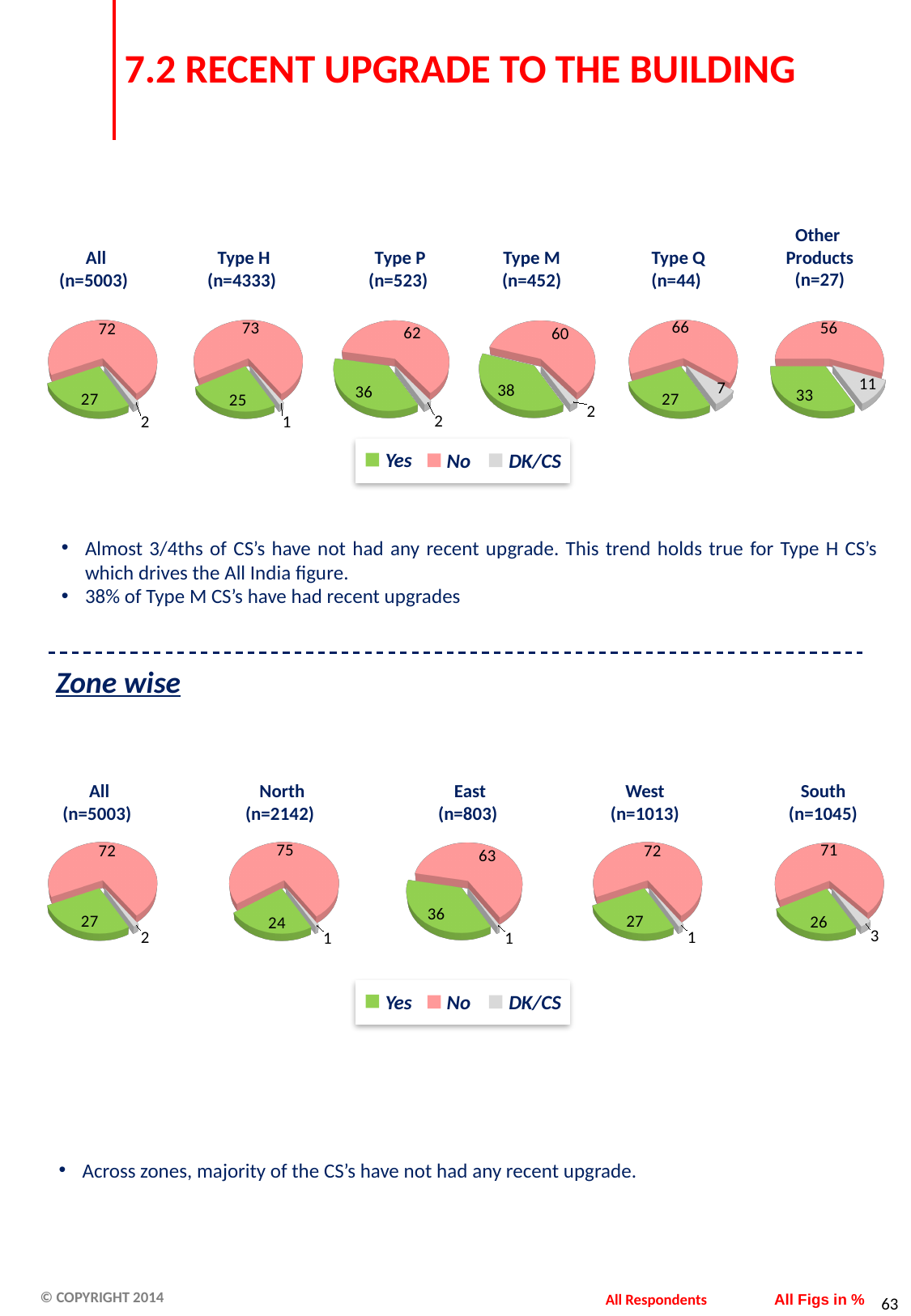
In the top row of pie charts, what is the 'DK/CS' value for Type Q (n=44)? 7 In the top row of pie charts, what is the 'No' value for Type H (n=4333)? 73 In the Zone wise row of pie charts, what is the 'DK/CS' value for South (n=1045)? 3 How many pie charts are in the Zone wise row? 5 In the top row of pie charts, which chart has the lowest 'No' value? Other Products (n=27) How many series does the legend list for the pie charts? 3 In the Zone wise row of pie charts, is the 'Yes' value for West larger or smaller than the 'Yes' value for East? smaller In the top row of pie charts, which chart has the highest 'Yes' value? Type M (n=452) In the top row of pie charts, what is the difference between the 'No' values for Type H and Type M? 13 In the top row of pie charts, what is the 'Yes' value for Type M (n=452)? 38 In the Zone wise row of pie charts, which zone has the highest 'No' value? North (n=2142) In the Zone wise row of pie charts, what is the 'Yes' value for East (n=803)? 36